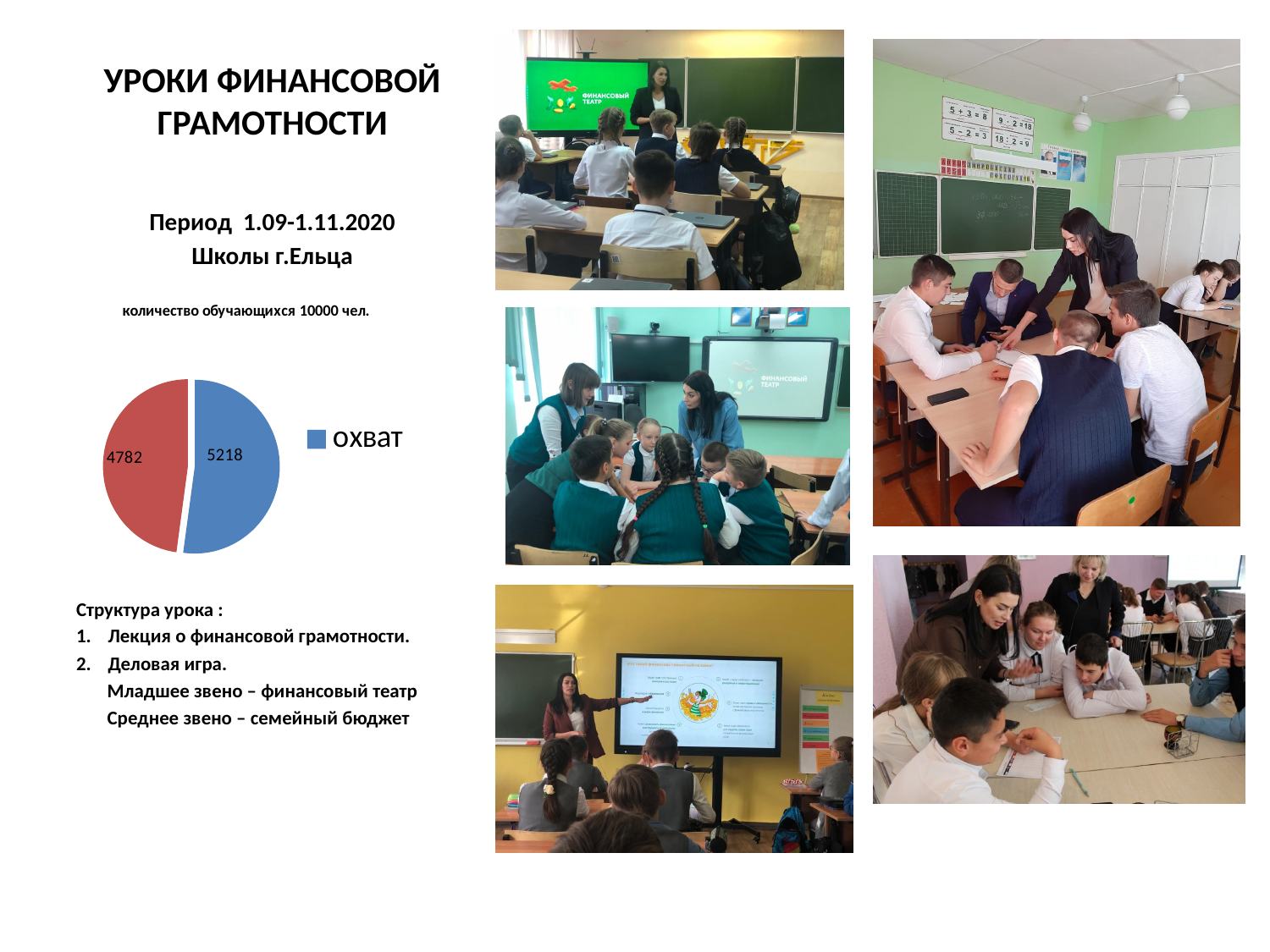
How many slices does the pie chart have? 2 What share of the pie does the blue slice (5218) represent? 52.18% Which slice of the pie chart has the larger value, the blue one or the red one? the blue one (5218) What kind of chart is shown on the slide? pie chart What colour is the slice labelled 5218 in the pie chart? blue What value is shown on the red slice of the pie chart? 4782 How many entries does the legend of the pie chart list? 1 What is the difference between the two values shown on the pie chart? 436 What is the total of the two values shown on the pie chart? 10000 What value is shown on the blue slice (охват) of the pie chart? 5218 What is the legend entry of the pie chart? охват Which slice of the pie chart has the smallest value? the red slice (4782)